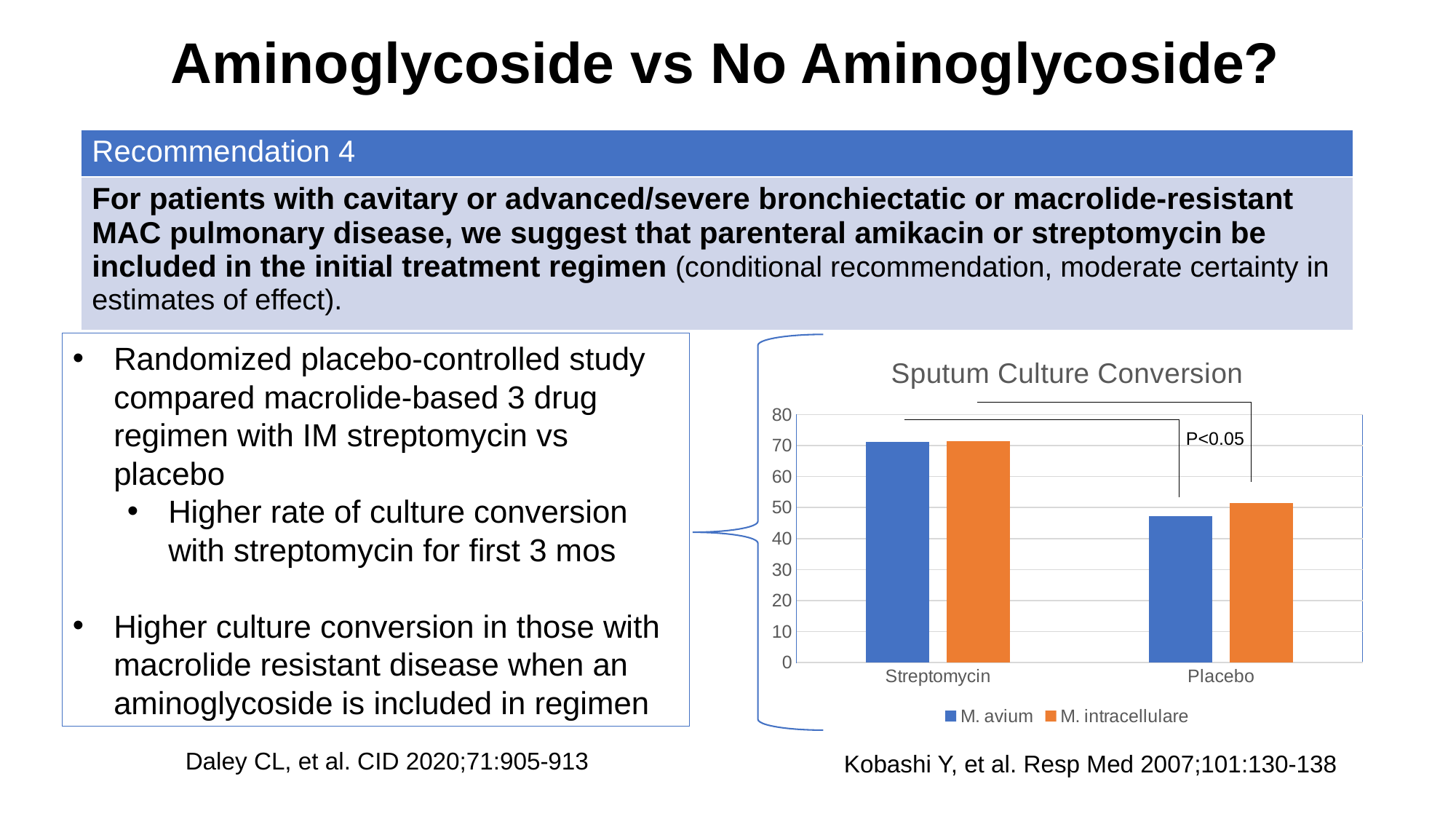
For M. intracellulare, which is larger: Streptomycin or Placebo? Streptomycin Which series is shown in orange in the chart? M. intracellulare Is the M. avium value for Placebo greater or less than 50? less What type of chart is shown on the slide? Bar chart Is the M. avium value for Streptomycin greater or less than 60? greater How many categories are shown on the x axis of the chart? 2 Is the M. intracellulare value for Placebo greater or less than 60? less For M. avium, which is larger: Streptomycin or Placebo? Streptomycin Which category has the highest M. avium value? Streptomycin Do the values rise or fall from Streptomycin to Placebo along the x axis? Fall What is the title of the chart on the slide? Sputum Culture Conversion How many series does the chart legend list? 2